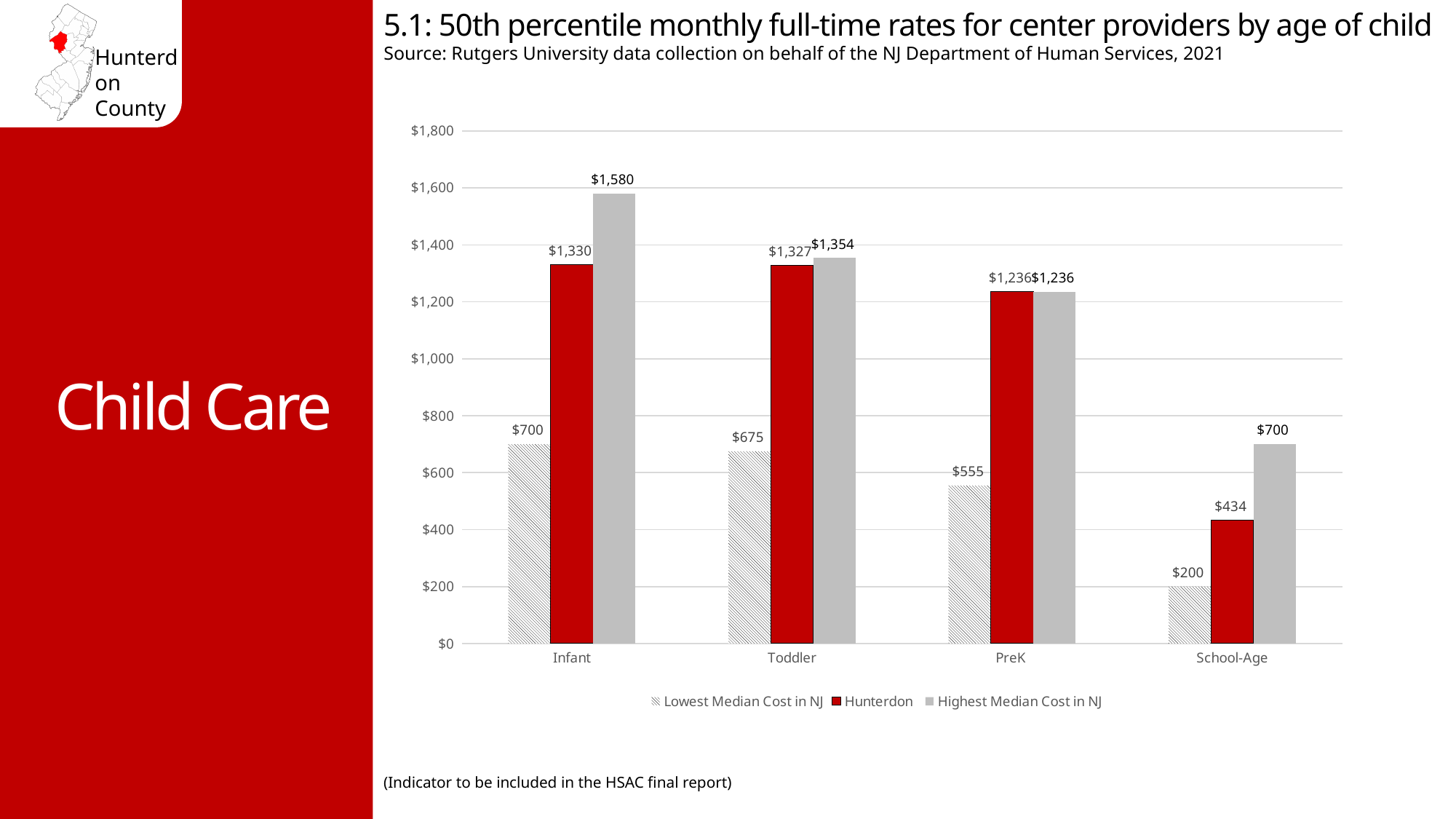
How many series does the legend list? 3 Is the Hunterdon value for School-Age greater or less than $600? less Which age group has the lowest Lowest Median Cost in NJ? School-Age What is the Lowest Median Cost in NJ for PreK? $555 What kind of chart is shown? bar chart What is the difference between the Highest Median Cost in NJ and the Hunterdon value for Infant? $250 How many age groups are shown on the x axis? 4 What colour are the Hunterdon bars? red Which age group has the highest Hunterdon value? Infant What is the Highest Median Cost in NJ for School-Age? $700 What is the Hunterdon value for Infant? $1,330 Which is larger for Toddler: the Hunterdon value or the Lowest Median Cost in NJ? Hunterdon